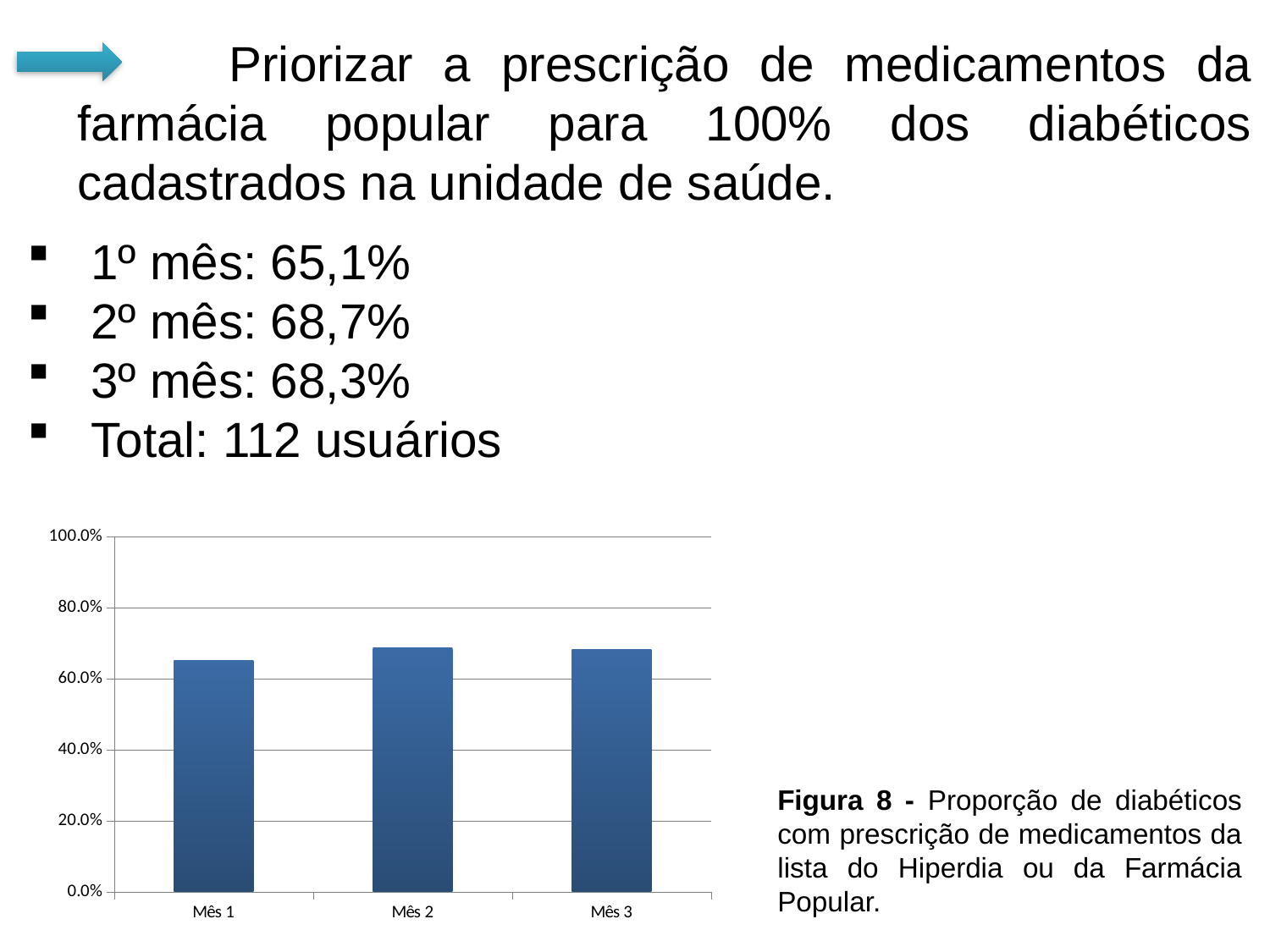
Is the value for Mês 2 greater or less than 80%? less Which is larger, the value for Mês 1 or the value for Mês 3? Mês 3 What is the highest value shown on the vertical axis of the chart? 100.0% How many categories (months) are plotted on the chart? 3 Is the value for Mês 3 greater or less than 80%? less Which month has the lowest bar on the chart? Mês 1 According to the slide, what is the proportion for the 1º mês (Mês 1)? 65,1% What kind of chart is shown on the slide? bar chart Is the value for Mês 1 greater or less than 60%? greater Does the value rise or fall from Mês 1 to Mês 2? rise According to the slide, what is the proportion for the 2º mês (Mês 2)? 68,7% Which is larger, the value for Mês 1 or the value for Mês 2? Mês 2